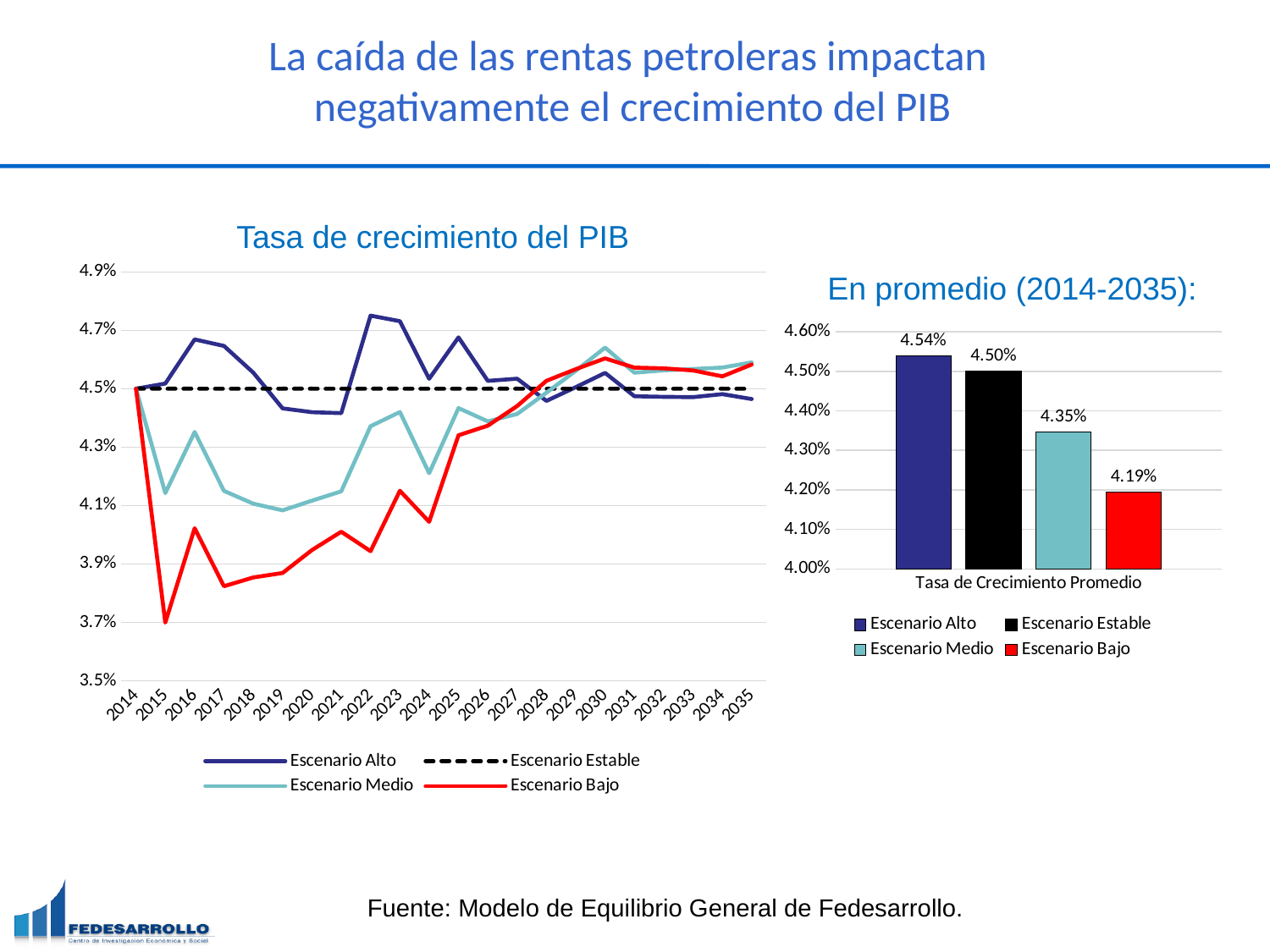
On the 'En promedio (2014-2035)' bar chart, which scenario has the lowest average growth rate? Escenario Bajo On the 'En promedio (2014-2035)' bar chart, which is larger, Escenario Estable or Escenario Medio? Escenario Estable On the 'Tasa de crecimiento del PIB' chart, which series is drawn as a dashed line? Escenario Estable On the 'En promedio (2014-2035)' bar chart, what is the difference between Escenario Alto and Escenario Bajo? 0.35 percentage points On the 'En promedio (2014-2035)' bar chart, what is the value for Escenario Bajo? 4.19% How many series does the legend of the 'Tasa de crecimiento del PIB' chart list? 4 On the 'Tasa de crecimiento del PIB' chart, is the value for Escenario Alto in 2022 greater or less than 4.7%? greater On the 'En promedio (2014-2035)' bar chart, what is the value for Escenario Medio? 4.35% What kind of chart is 'Tasa de crecimiento del PIB'? Line chart On the 'En promedio (2014-2035)' bar chart, what is the value for Escenario Alto? 4.54% On the 'En promedio (2014-2035)' bar chart, which scenario has the highest average growth rate? Escenario Alto On the 'Tasa de crecimiento del PIB' chart, is the value for Escenario Bajo in 2015 greater or less than 3.9%? less